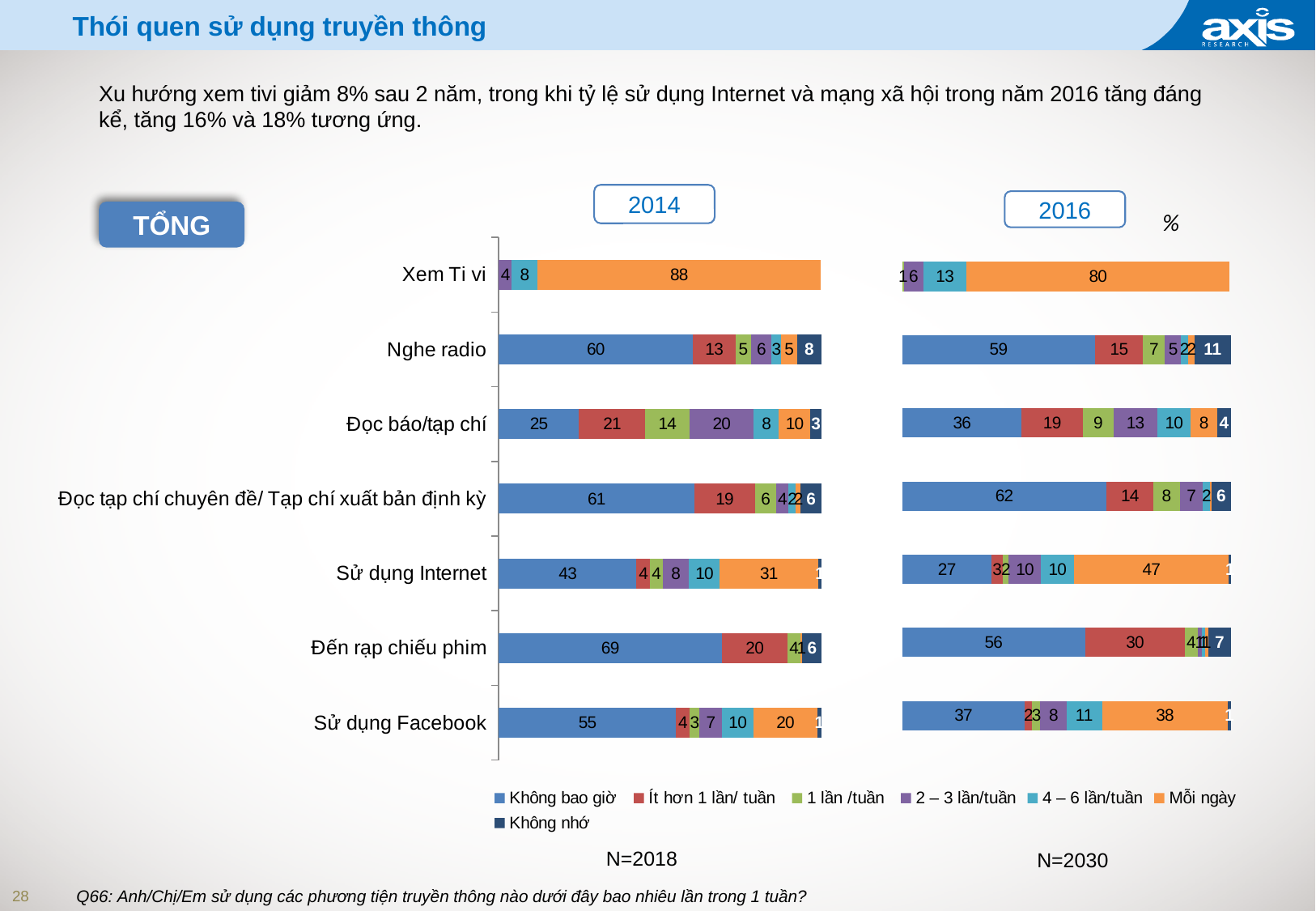
What type of chart is used for the 2014 data? Stacked bar chart In the 2016 chart, what is the 'Không bao giờ' value for Đọc báo/tạp chí? 36 What is the difference between the 'Mỗi ngày' value for Xem Ti vi in the 2014 chart and in the 2016 chart? 8 How many categories are shown in the 2016 chart? 7 In the 2014 chart, what is the 'Mỗi ngày' value for Xem Ti vi? 88 In the 2016 chart, what is the 'Mỗi ngày' value for Sử dụng Internet? 47 In the 2014 chart, what is the '2 – 3 lần/tuần' value for Đọc báo/tạp chí? 20 In the 2016 chart, which category has the highest 'Mỗi ngày' value? Xem Ti vi How many series does the legend list? 7 By how much did the 'Mỗi ngày' value for Sử dụng Facebook increase from the 2014 chart to the 2016 chart? 18 In the 2014 chart, which category has the highest 'Không bao giờ' value? Đến rạp chiếu phim Is the 'Không nhớ' value for Nghe radio larger in the 2014 chart or the 2016 chart? 2016